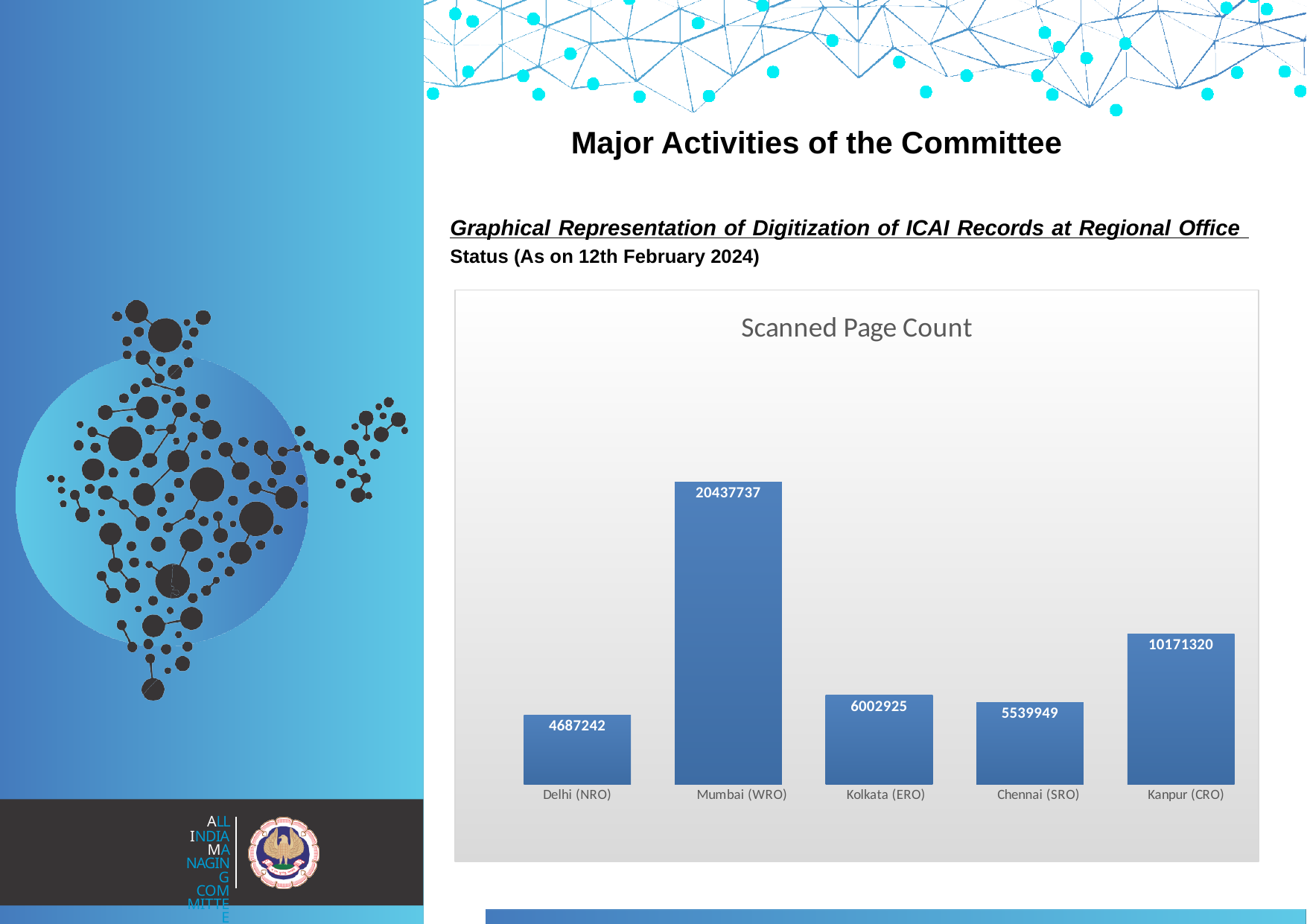
What is the scanned page count for Kanpur (CRO)? 10171320 Which regional office has the highest scanned page count? Mumbai (WRO) Which regional office has the lowest scanned page count? Delhi (NRO) Which has a larger scanned page count, Kolkata (ERO) or Chennai (SRO)? Kolkata (ERO) How many regional offices are shown in the chart? 5 What is the scanned page count for Delhi (NRO)? 4687242 What is the title of the chart? Scanned Page Count What is the difference in scanned page count between Mumbai (WRO) and Kanpur (CRO)? 10266417 What type of chart is used to show the scanned page count? Bar chart What is the difference in scanned page count between Kolkata (ERO) and Chennai (SRO)? 462976 What is the scanned page count for Mumbai (WRO)? 20437737 What is the scanned page count for Chennai (SRO)? 5539949